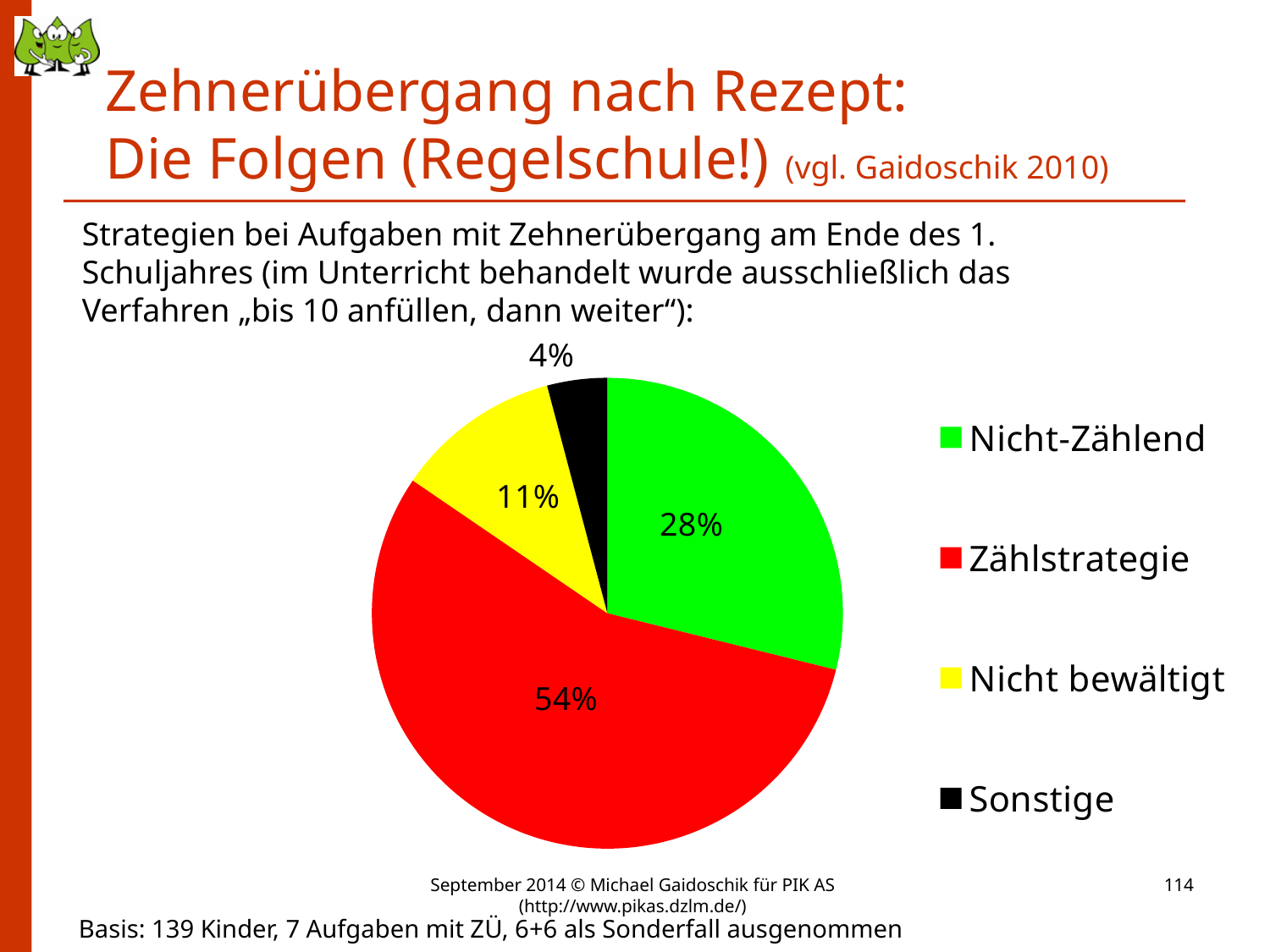
What share of the pie does Sonstige have? 4% What share of the pie does Nicht bewältigt have? 11% What type of chart is shown on the slide? pie chart How many categories does the pie chart show? 4 Which category has the largest slice of the pie? Zählstrategie What colour is the slice for Zählstrategie? red Which is larger, the share for Nicht bewältigt or the share for Sonstige? Nicht bewältigt What share of the pie does Zählstrategie have? 54% Which legend entry is shown in yellow? Nicht bewältigt What is the difference in percentage points between Zählstrategie and Nicht-Zählend? 26 Which category has the smallest slice of the pie? Sonstige